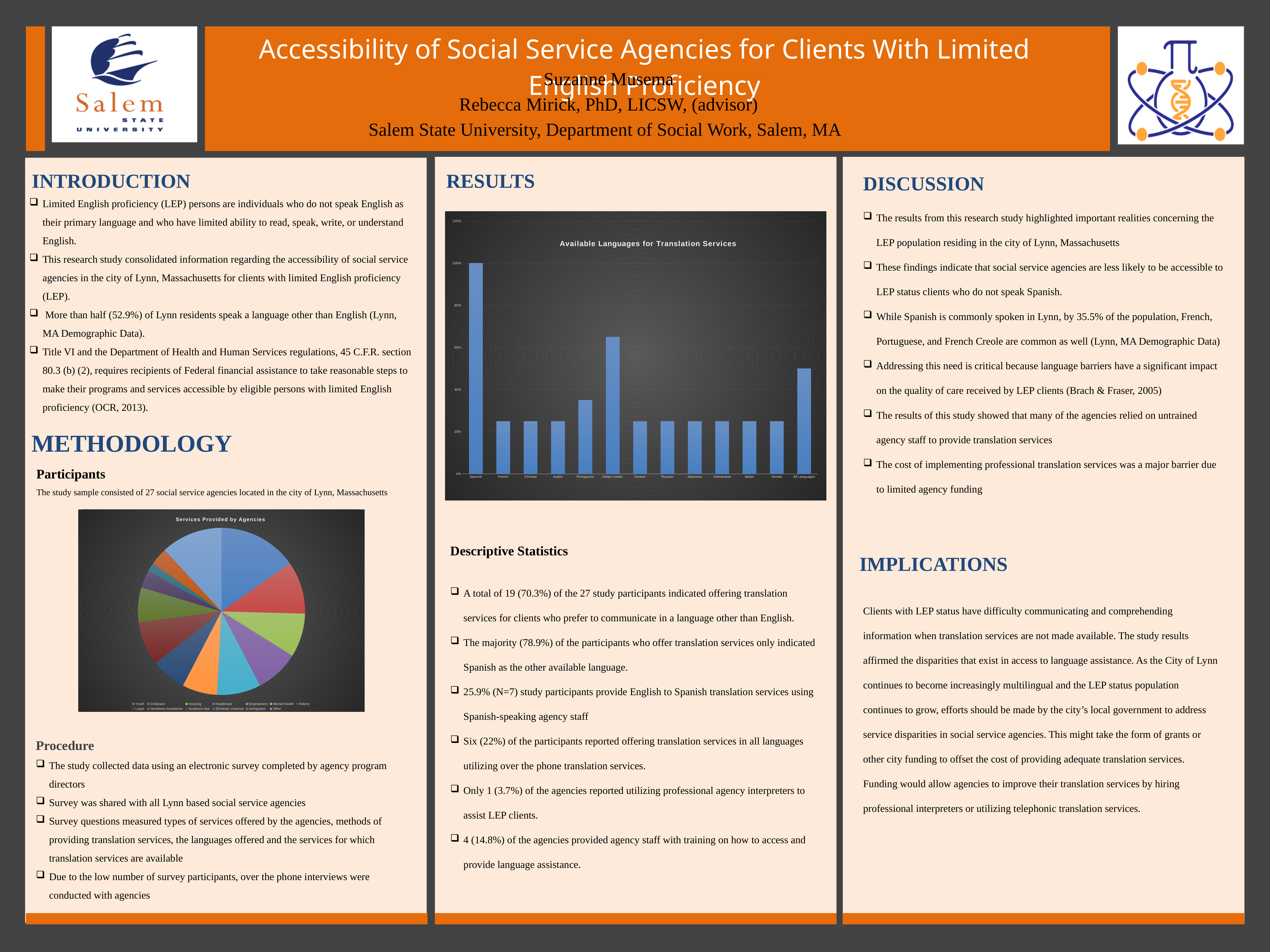
In the 'Available Languages for Translation Services' chart, is the value for Haitian creole greater or less than 60%? greater In the 'Available Languages for Translation Services' chart, is the value for French greater or less than 40%? less What kind of chart is the 'Services Provided by Agencies' chart? pie chart In the 'Available Languages for Translation Services' chart, which language has the highest value? Spanish In the 'Available Languages for Translation Services' chart, what is the value for Spanish? 100% In the 'Available Languages for Translation Services' chart, is the value for Portuguese greater or less than 40%? less What kind of chart is the 'Available Languages for Translation Services' chart? bar chart How many entries does the legend of the 'Services Provided by Agencies' pie chart list? 13 In the 'Available Languages for Translation Services' chart, which is larger, Haitian creole or Portuguese? Haitian creole How many categories are shown on the x axis of the 'Available Languages for Translation Services' chart? 13 In the 'Available Languages for Translation Services' chart, which is larger, Spanish or All Languages? Spanish